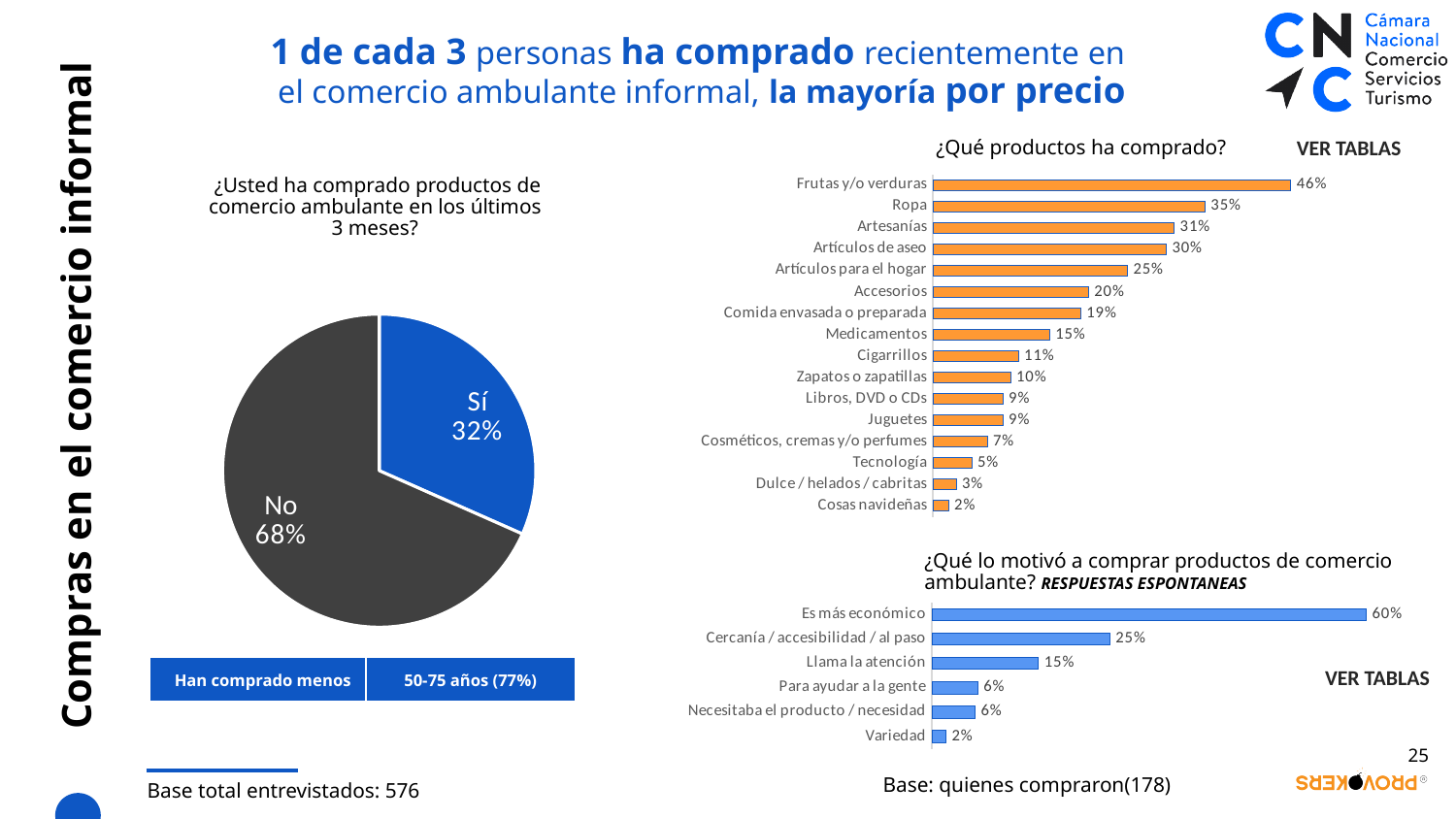
In the pie chart '¿Usted ha comprado productos de comercio ambulante en los últimos 3 meses?', which answer has the larger share, 'Sí' or 'No'? No In the pie chart '¿Usted ha comprado productos de comercio ambulante en los últimos 3 meses?', what share of respondents answered 'Sí'? 32% In the chart '¿Qué productos ha comprado?', what is the value for 'Ropa'? 35% In the chart '¿Qué lo motivó a comprar productos de comercio ambulante?', what is the difference between 'Es más económico' and 'Cercanía / accesibilidad / al paso'? 35% In the chart '¿Qué productos ha comprado?', which product has the lowest value? Cosas navideñas In the chart '¿Qué lo motivó a comprar productos de comercio ambulante?', what is the value for 'Es más económico'? 60% In the chart '¿Qué productos ha comprado?', how many product categories are shown? 16 What type of chart is used for '¿Qué lo motivó a comprar productos de comercio ambulante?'? Bar chart In the chart '¿Qué productos ha comprado?', what is the value for 'Medicamentos'? 15% In the chart '¿Qué lo motivó a comprar productos de comercio ambulante?', how many categories are shown? 6 In the chart '¿Qué productos ha comprado?', what is the difference between 'Artesanías' and 'Artículos de aseo'? 1% In the chart '¿Qué productos ha comprado?', which product has the highest value? Frutas y/o verduras